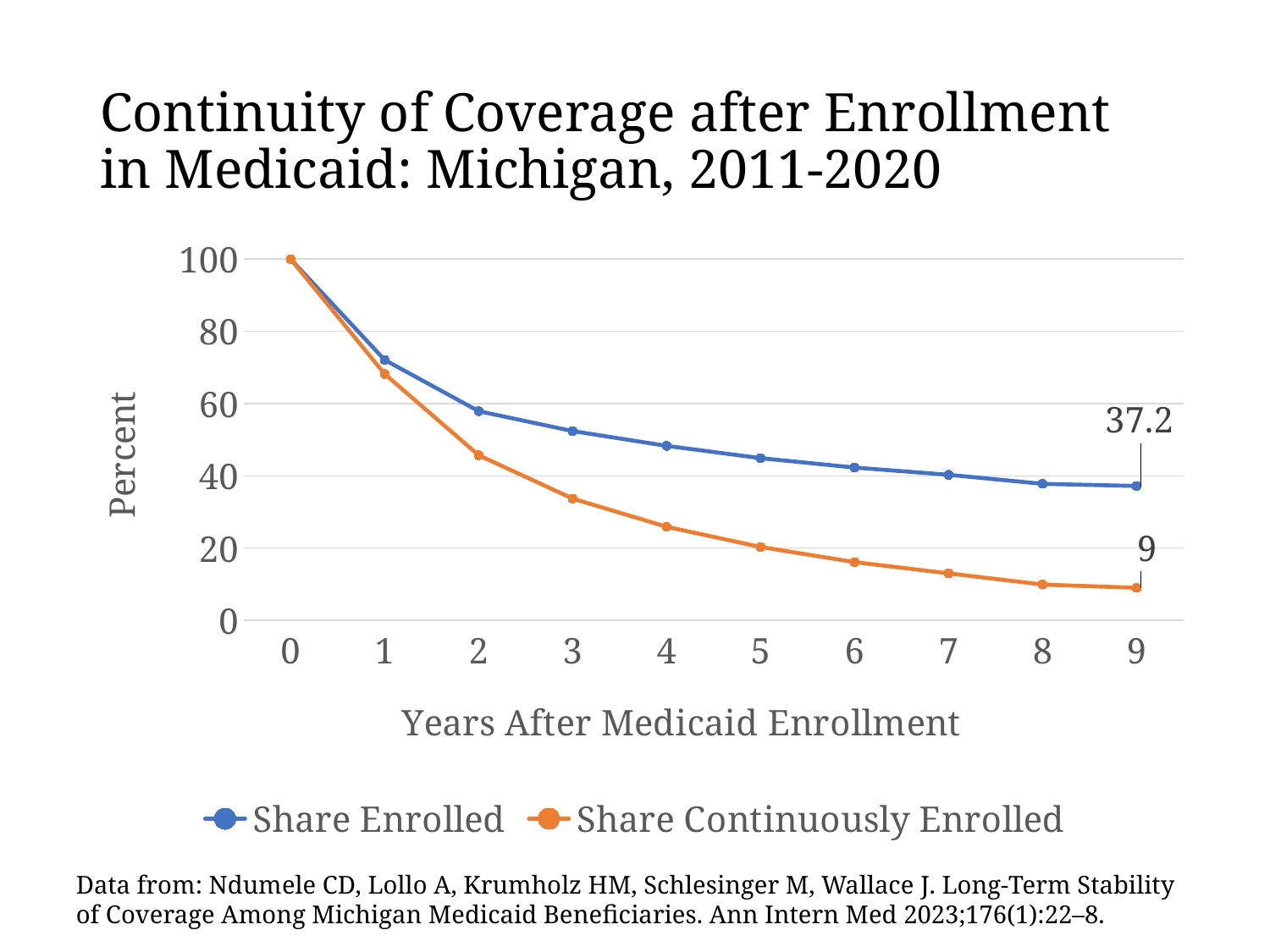
Do the values for Share Enrolled rise or fall as years after enrollment increase? fall What is the difference between Share Enrolled and Share Continuously Enrolled at year 9? 28.2 How many points are plotted along the x axis for each series? 10 How many series does the legend list? 2 What is the value of both series at 0 years after Medicaid enrollment? 100 What is the value of Share Enrolled at 9 years after Medicaid enrollment? 37.2 At year 9, which series has the larger value, Share Enrolled or Share Continuously Enrolled? Share Enrolled What kind of chart is shown on the slide? line chart Is the value for Share Enrolled at year 1 greater or less than 60? greater Is the value for Share Continuously Enrolled at year 2 greater or less than 60? less What is the value of Share Continuously Enrolled at 9 years after Medicaid enrollment? 9 Is the value for Share Continuously Enrolled at year 5 greater or less than 40? less